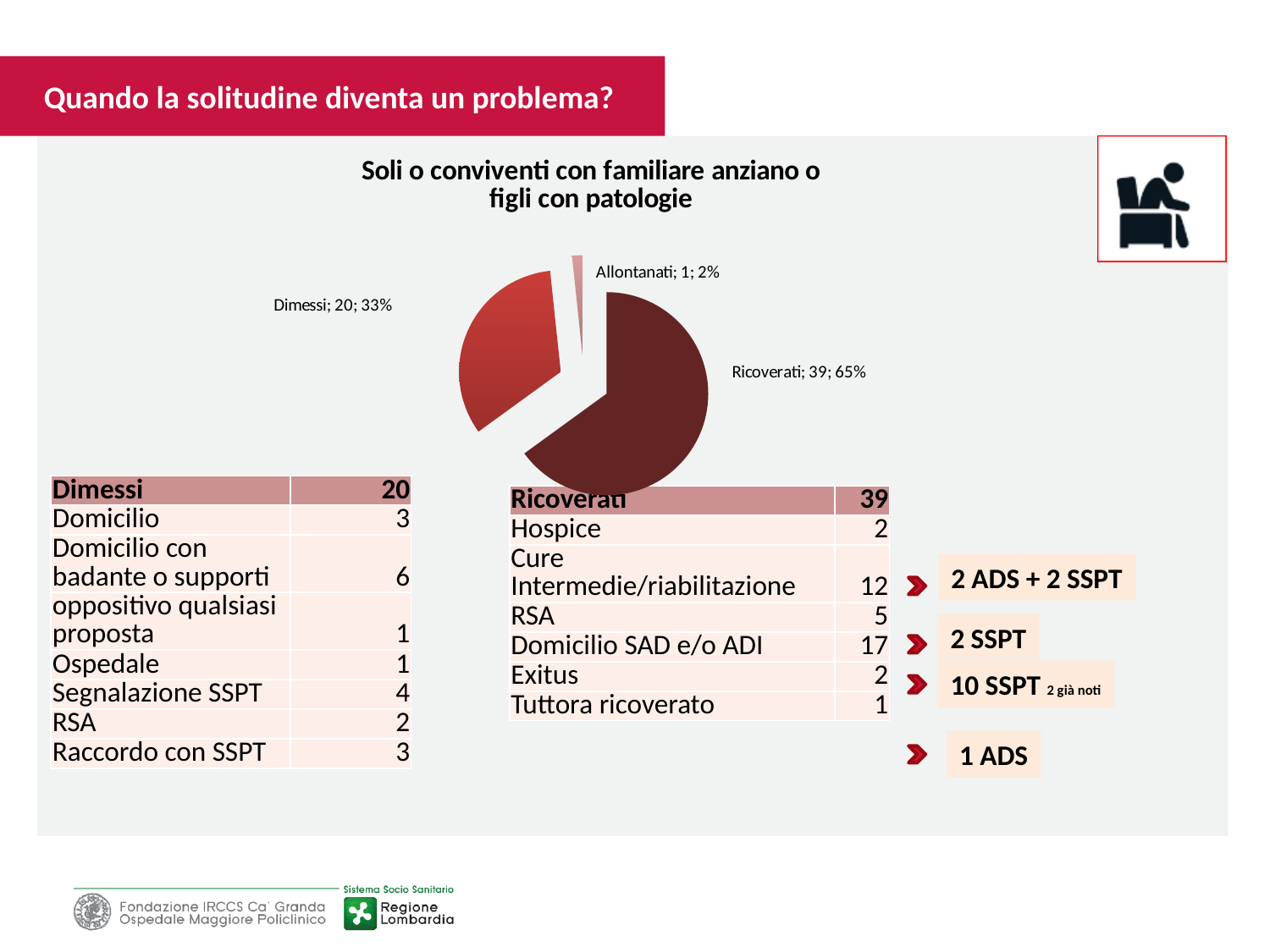
Which slice of the pie chart is the smallest? Allontanati What share of the pie does Allontanati represent? 2% What share of the pie does Ricoverati represent? 65% What is the value for Allontanati in the pie chart? 1 What is the title of the pie chart? Soli o conviventi con familiare anziano o figli con patologie What share of the pie does Dimessi represent? 33% What is the difference between the values for Ricoverati and Dimessi in the pie chart? 19 What is the value for Dimessi in the pie chart? 20 Which slice of the pie chart is the largest? Ricoverati What kind of chart is shown on the slide? pie chart How many slices does the pie chart have? 3 What is the value for Ricoverati in the pie chart? 39